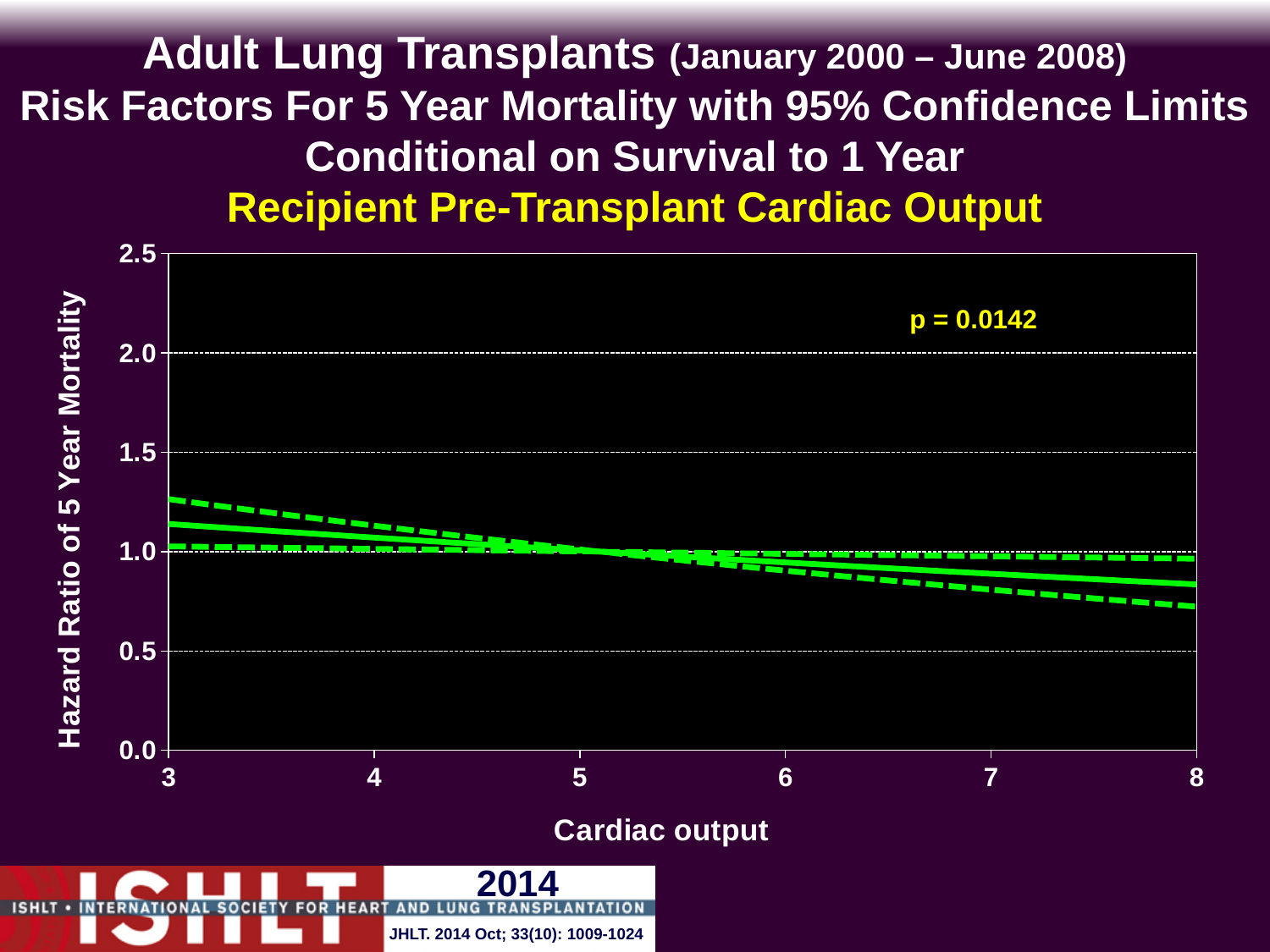
Is the hazard ratio at a cardiac output of 3 larger or smaller than at a cardiac output of 8? larger What range of cardiac output does the x axis cover? 3 to 8 Is the hazard ratio (solid line) at a cardiac output of 3 greater or less than 1.0? greater How many lines are plotted on the chart (the estimate plus its confidence limits)? 3 What is the highest value shown on the y axis of the chart? 2.5 Is the hazard ratio (solid line) at a cardiac output of 8 greater or less than 1.0? less Is the upper confidence limit at a cardiac output of 3 greater or less than 1.5? less Does the hazard ratio of 5 year mortality rise or fall as cardiac output increases from 3 to 8? fall What is the label of the x axis? Cardiac output What p-value is printed on the chart? p = 0.0142 What kind of chart is shown on the slide? line chart